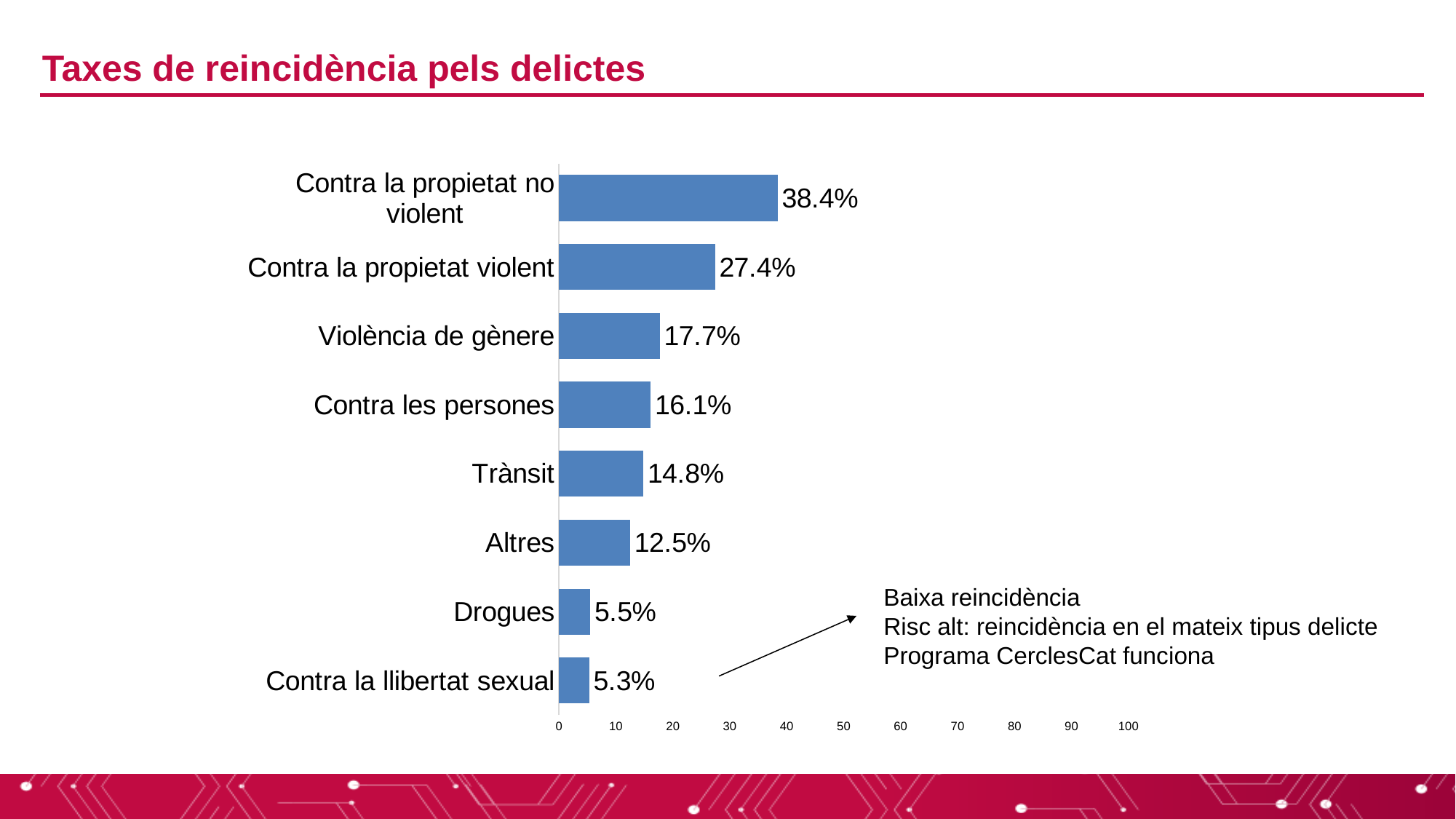
What is the difference between the values for 'Contra la propietat no violent' and 'Contra la propietat violent'? 11.0 percentage points What kind of chart is shown on the slide? Bar chart What is the value shown for 'Violència de gènere'? 17.7% How many categories are shown in the chart? 8 Is the value for 'Contra la propietat violent' greater or less than 30? less Which category has the lowest recidivism rate? Contra la llibertat sexual Which category has the highest recidivism rate? Contra la propietat no violent What is the difference between the values for 'Trànsit' and 'Altres'? 2.3 percentage points What is the recidivism rate for 'Contra la propietat no violent'? 38.4% What is the value shown for 'Drogues'? 5.5% What is the title of the slide? Taxes de reincidència pels delictes Which is larger, the value for 'Contra les persones' or the value for 'Trànsit'? Contra les persones